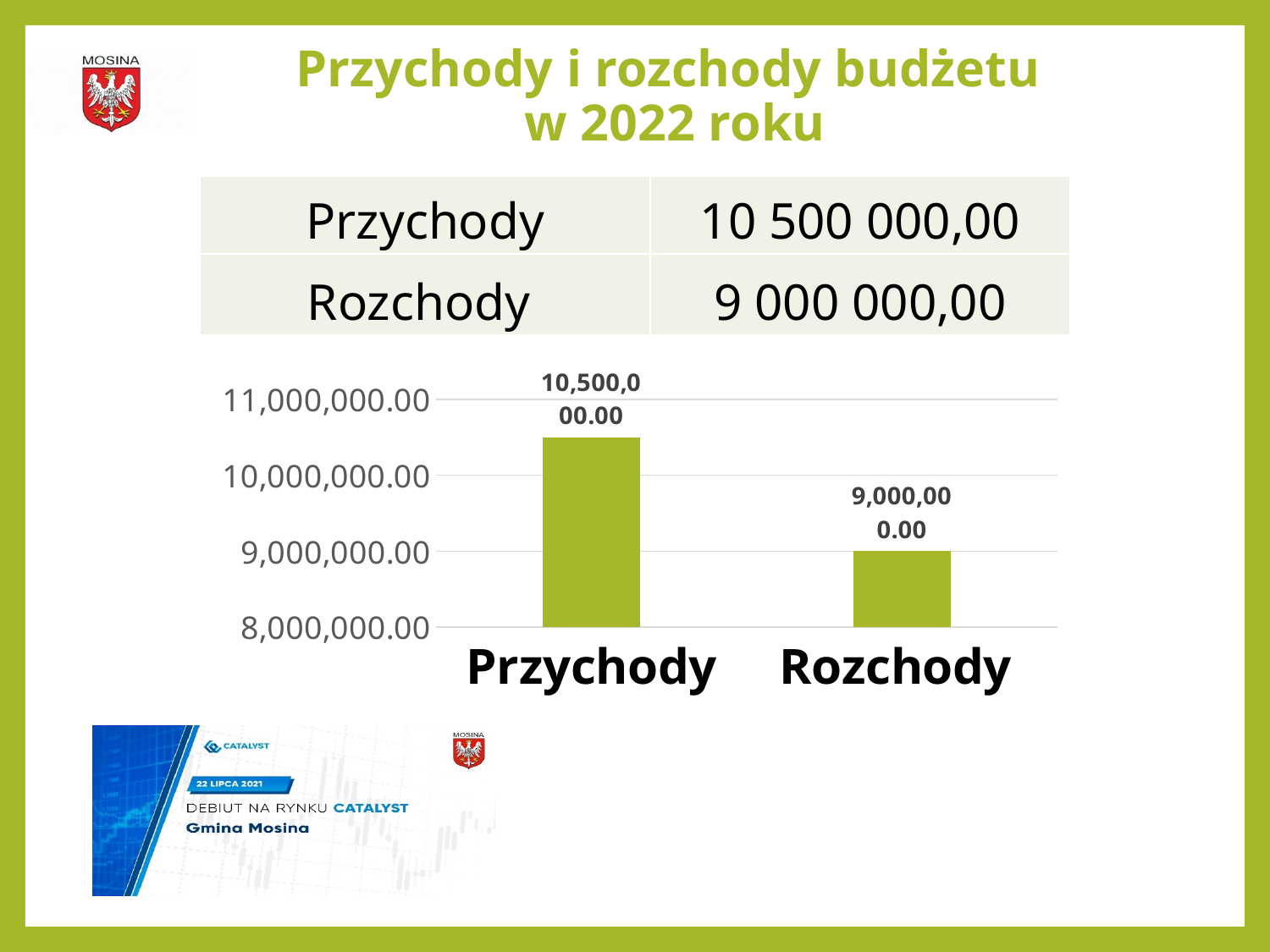
Is the value for Rozchody greater or less than 10,000,000.00? less What is the difference between the Przychody and Rozchody values in the chart? 1,500,000.00 What is the value of the Rozchody bar in the chart? 9,000,000.00 What colour are the bars in the chart? green What is the lowest value shown on the chart's vertical axis? 8,000,000.00 Which is larger in the chart, Przychody or Rozchody? Przychody How many categories are shown in the chart? 2 Which category has the highest bar in the chart? Przychody What kind of chart is shown on the slide? bar chart What is the value of the Przychody bar in the chart? 10,500,000.00 Which category has the lowest bar in the chart? Rozchody Is the value for Przychody greater or less than 10,000,000.00? greater